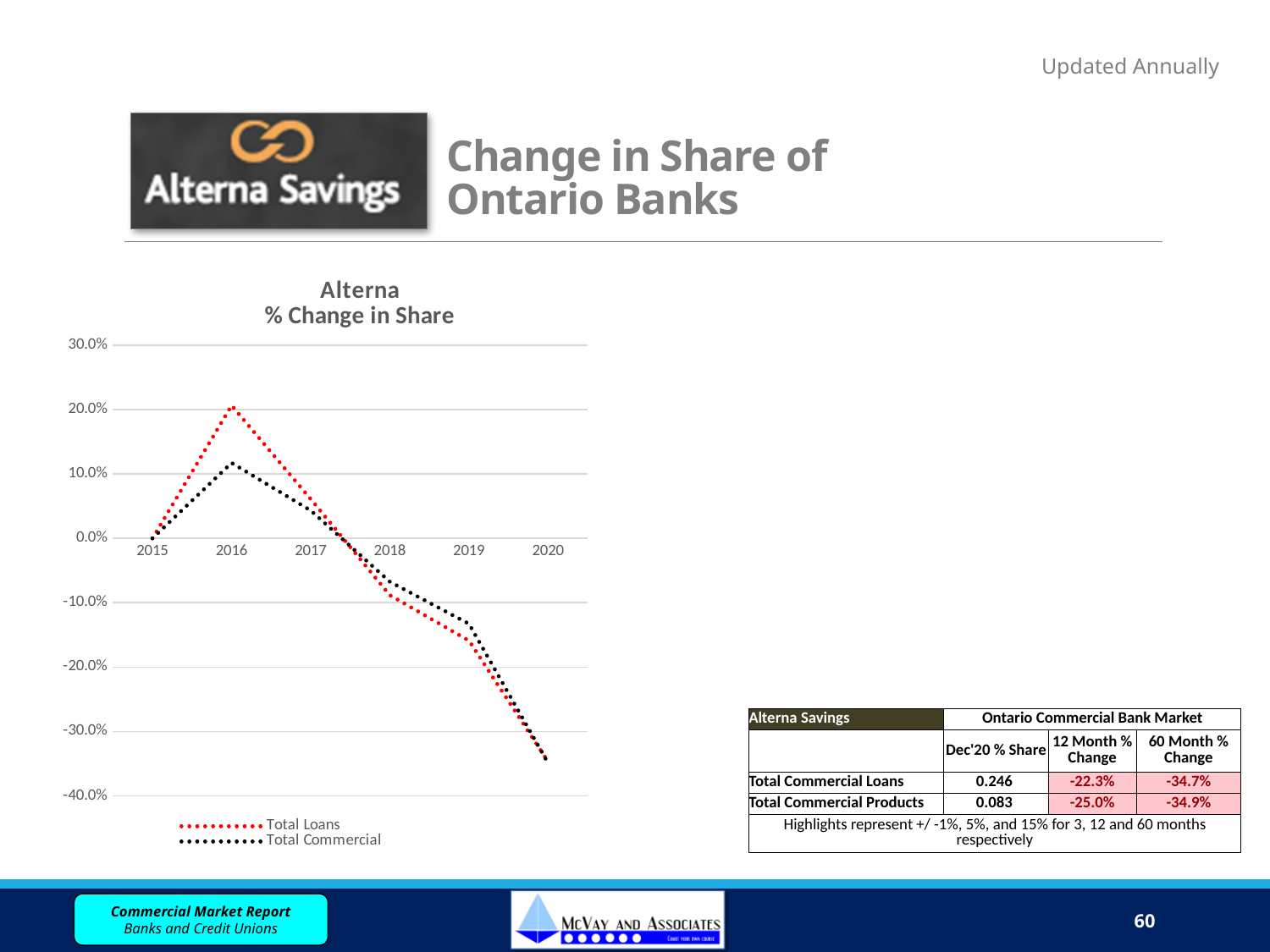
Is the value for Total Commercial in 2019 greater or less than -20.0%? greater Is the value for Total Loans in 2016 greater or less than 10.0%? greater From 2016 to 2020, do the values of the Total Loans series rise or fall? fall Is the value for Total Loans in 2020 greater or less than -30.0%? less In which year does the Total Commercial series reach its lowest value? 2020 In which year does the Total Loans series reach its highest value? 2016 How many years are shown on the x axis of the chart? 6 In 2016, which series has the larger value, Total Loans or Total Commercial? Total Loans How many series does the legend of the "Alterna % Change in Share" chart list? 2 What kind of chart is shown on the slide? line chart Which series is drawn with the red dotted line? Total Loans